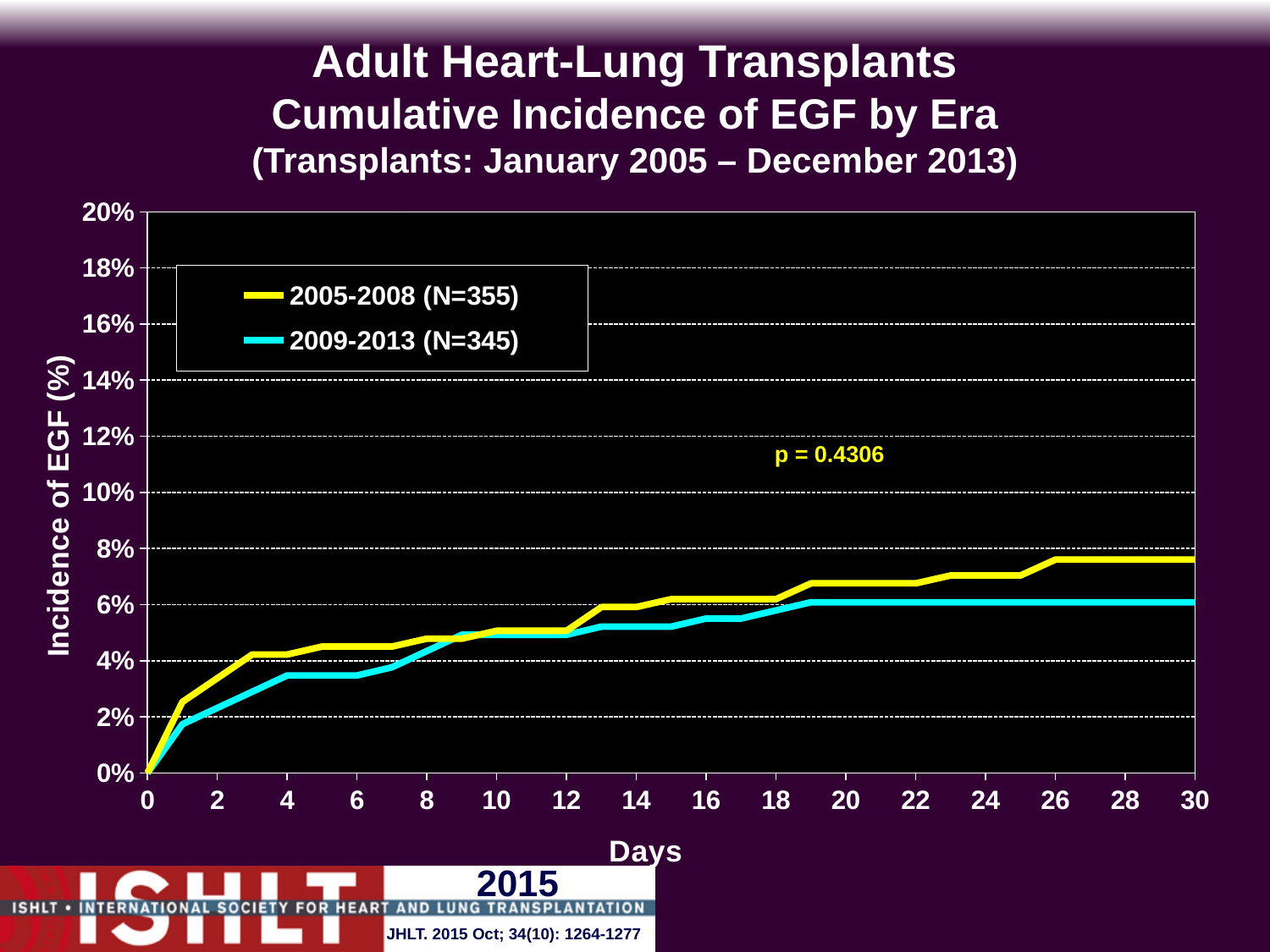
Is the value for the 2005-2008 (N=355) series at day 30 greater or less than 10%? less What kind of chart is shown on the slide? Line chart Is the value for the 2009-2013 (N=345) series at day 4 greater or less than 4%? less At day 30, which series has the higher cumulative incidence of EGF, 2005-2008 (N=355) or 2009-2013 (N=345)? 2005-2008 (N=355) Do the values for the 2009-2013 (N=345) series rise or fall as days increase? Rise Is the value for the 2005-2008 (N=355) series at day 30 greater or less than 6%? greater How many series does the legend list? 2 Which series does the yellow line represent? 2005-2008 (N=355) At day 4, which series has the higher cumulative incidence of EGF, 2005-2008 (N=355) or 2009-2013 (N=345)? 2005-2008 (N=355) Do the values for the 2005-2008 (N=355) series rise or fall as days increase? Rise What p-value is printed on the chart? p = 0.4306